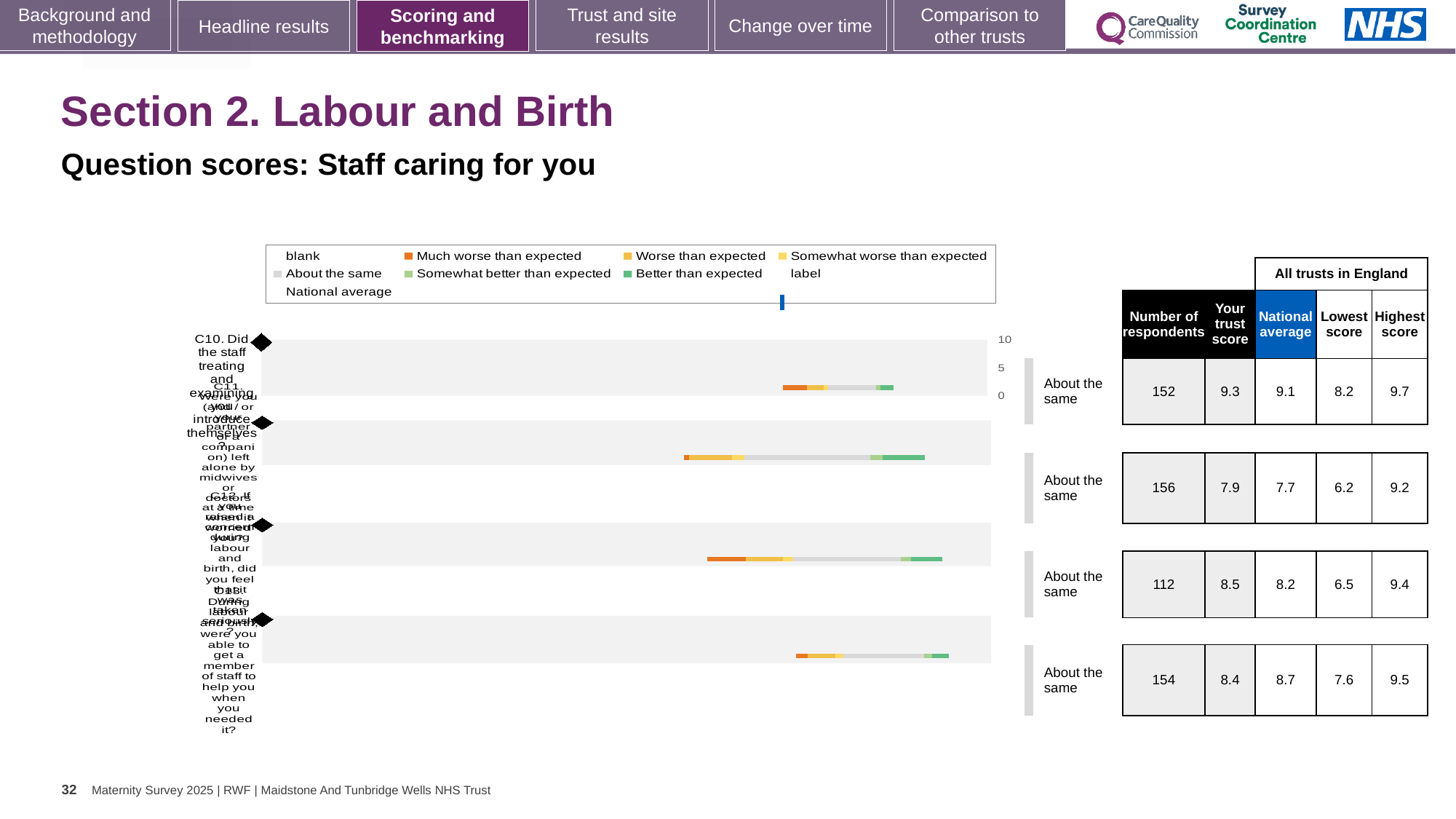
In the table beside the chart, what is the highest score for the fourth row (C13)? 9.5 How many question rows (bars) are plotted in the chart? 4 What kind of chart is shown on the slide? bar chart For the fourth row (C13), which is larger: 'Your trust score' or the national average? National average In the chart legend, what colour represents 'Much worse than expected'? orange For the third row (C12), which is larger: 'Your trust score' or the national average? Your trust score Which row has the lowest 'Lowest score' in the table beside the chart? the second row (C11), 6.2 In the table beside the chart, what is the number of respondents for the first row (C10)? 152 Which row has the highest 'Your trust score' in the table beside the chart? the first row (C10), 9.3 In the table beside the chart, what is 'Your trust score' for the second row (C11)? 7.9 In the chart legend, what colour represents 'About the same'? grey For the first row (C10), what is the difference between 'Your trust score' and the national average? 0.2